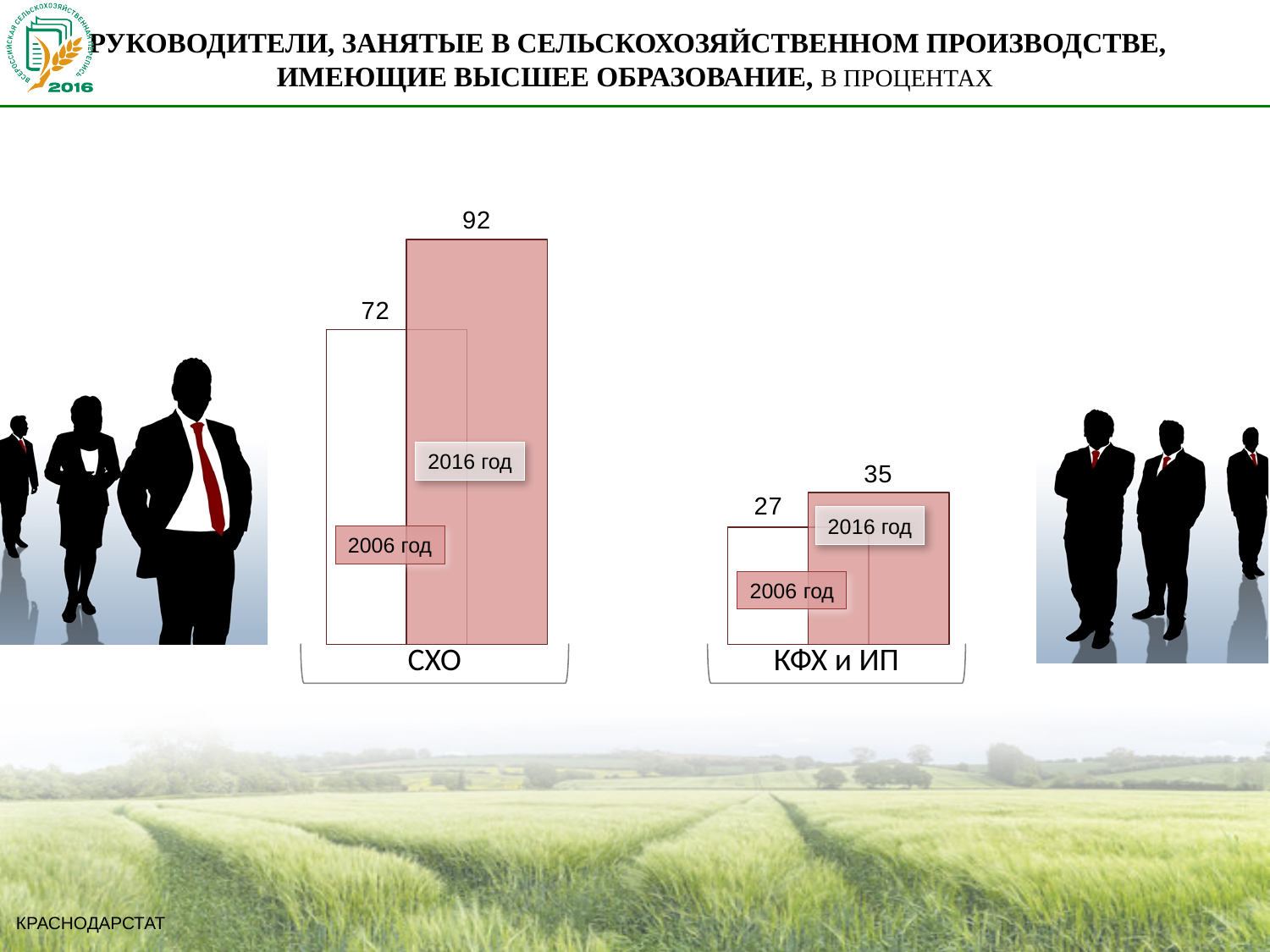
Which category has the highest value in 2016 год? СХО What is the value for СХО in 2016 год? 92 What is the value for СХО in 2006 год? 72 What is the value for КФХ и ИП in 2006 год? 27 What kind of chart is shown on the slide? Bar chart What is the value for КФХ и ИП in 2016 год? 35 How many categories are shown on the chart? 2 Which category has the lowest value in 2006 год? КФХ и ИП How many series does the chart show? 2 What is the difference between the 2016 год and 2006 год values for КФХ и ИП? 8 Which is larger: the 2006 год value for СХО or the 2016 год value for КФХ и ИП? 2006 год value for СХО What is the difference between the 2016 год and 2006 год values for СХО? 20